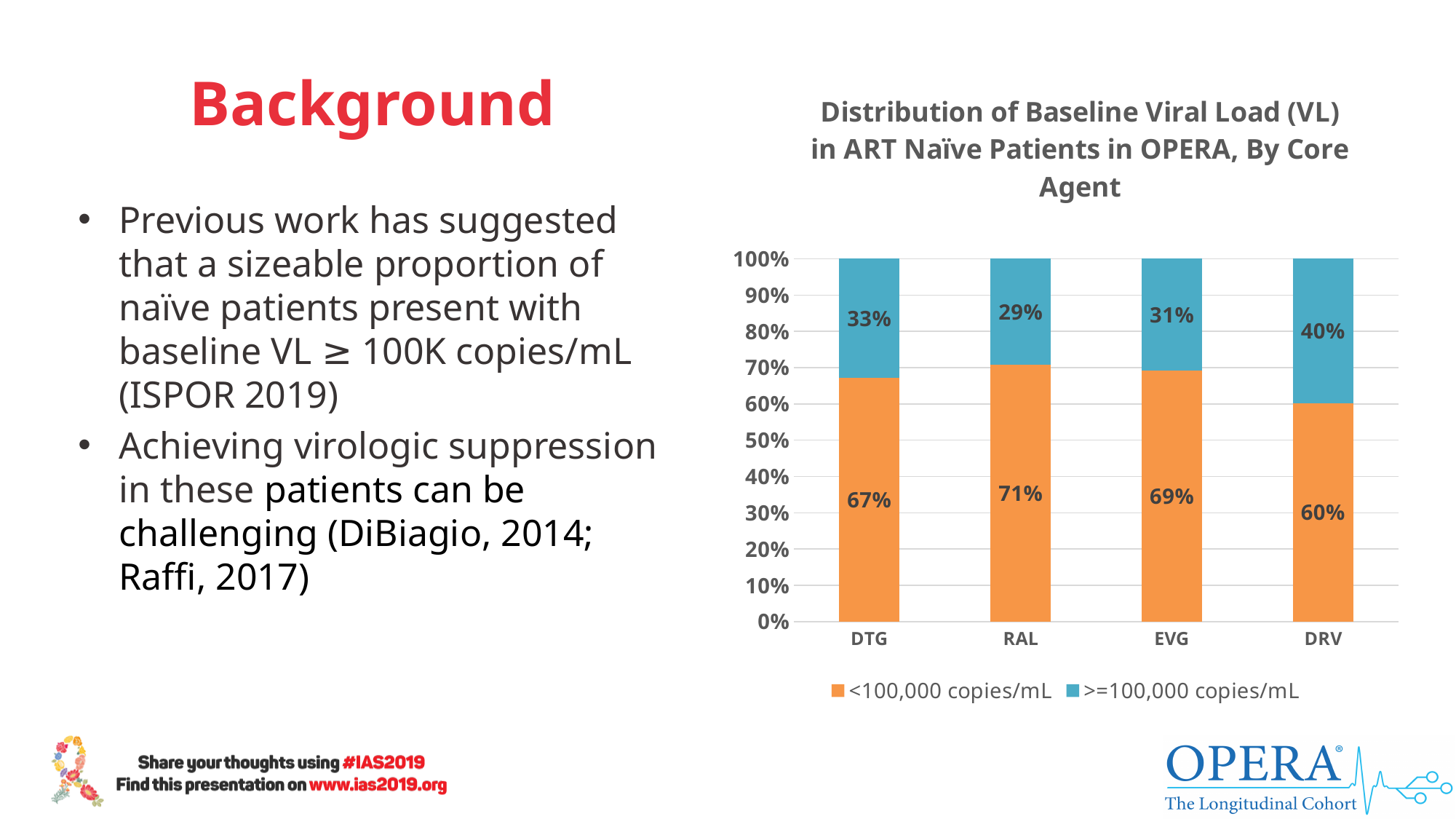
What percentage of ART naïve patients on DRV had a baseline VL >=100,000 copies/mL? 40% What kind of chart is shown on the slide? Stacked bar chart How many series does the chart legend list? 2 Which is larger: the >=100,000 copies/mL share for DTG or for EVG? DTG What percentage of ART naïve patients on EVG had a baseline VL >=100,000 copies/mL? 31% What percentage of ART naïve patients on DTG had a baseline VL <100,000 copies/mL? 67% Which colour represents the >=100,000 copies/mL series in the chart? Blue What is the difference between the <100,000 copies/mL percentages for RAL and DRV? 11% Which core agent has the lowest share of patients with baseline VL >=100,000 copies/mL? RAL Which core agent has the highest share of patients with baseline VL >=100,000 copies/mL? DRV How many core agents are shown on the x axis of the chart? 4 What percentage of ART naïve patients on RAL had a baseline VL <100,000 copies/mL? 71%